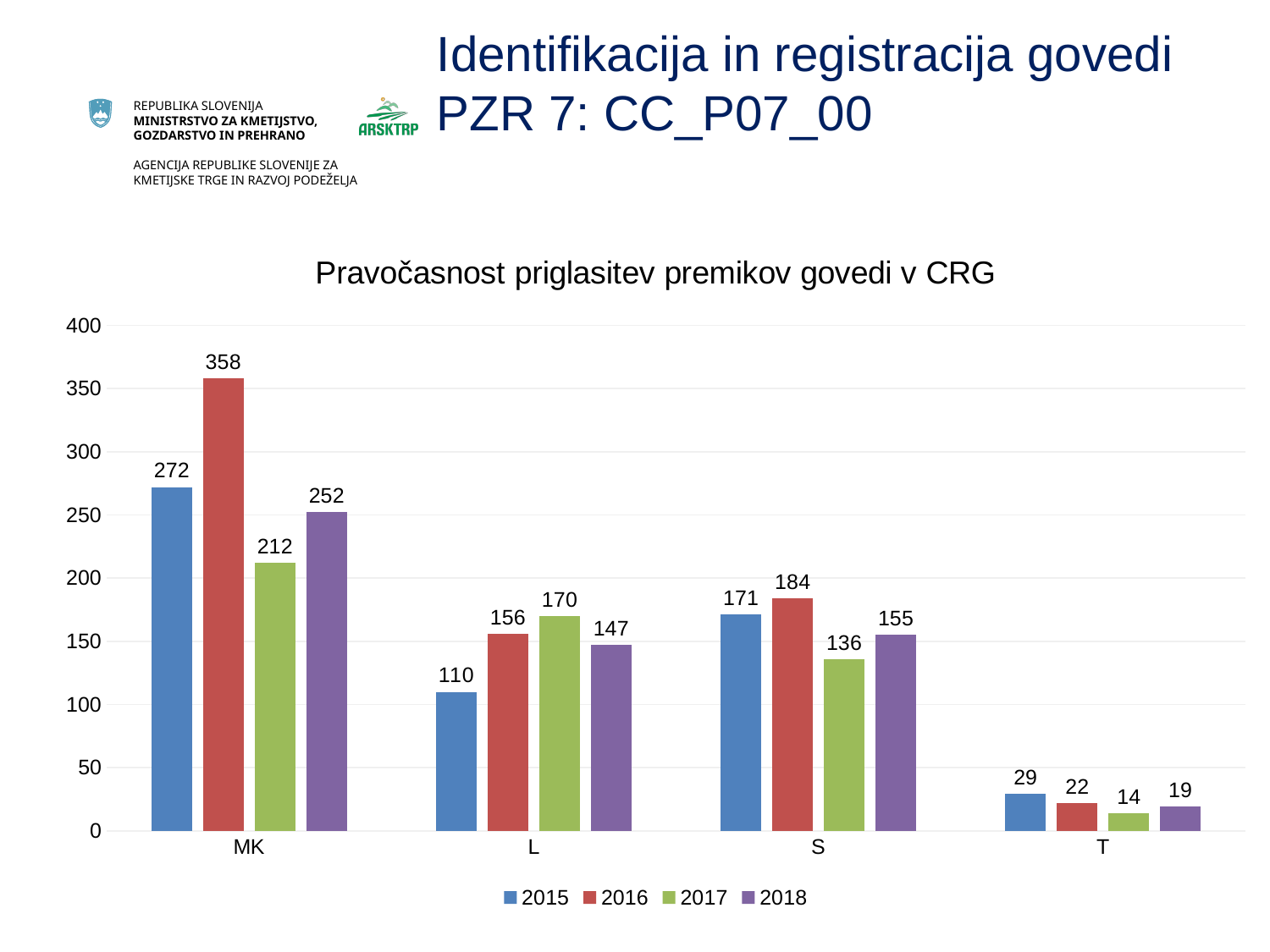
What is the value for L in 2015? 110 Is the value for L in 2017 greater or less than 150? greater What is the value for MK in 2016? 358 What kind of chart is shown? bar chart Which category has the highest value in 2018? MK How many categories are shown on the x axis? 4 Which category has the lowest value in 2015? T How many series does the legend list? 4 What is the difference between the 2016 and 2015 values for MK? 86 What is the value for T in 2017? 14 Which is larger for S: the 2017 value or the 2018 value? 2018 What is the title of the chart? Pravočasnost priglasitev premikov govedi v CRG